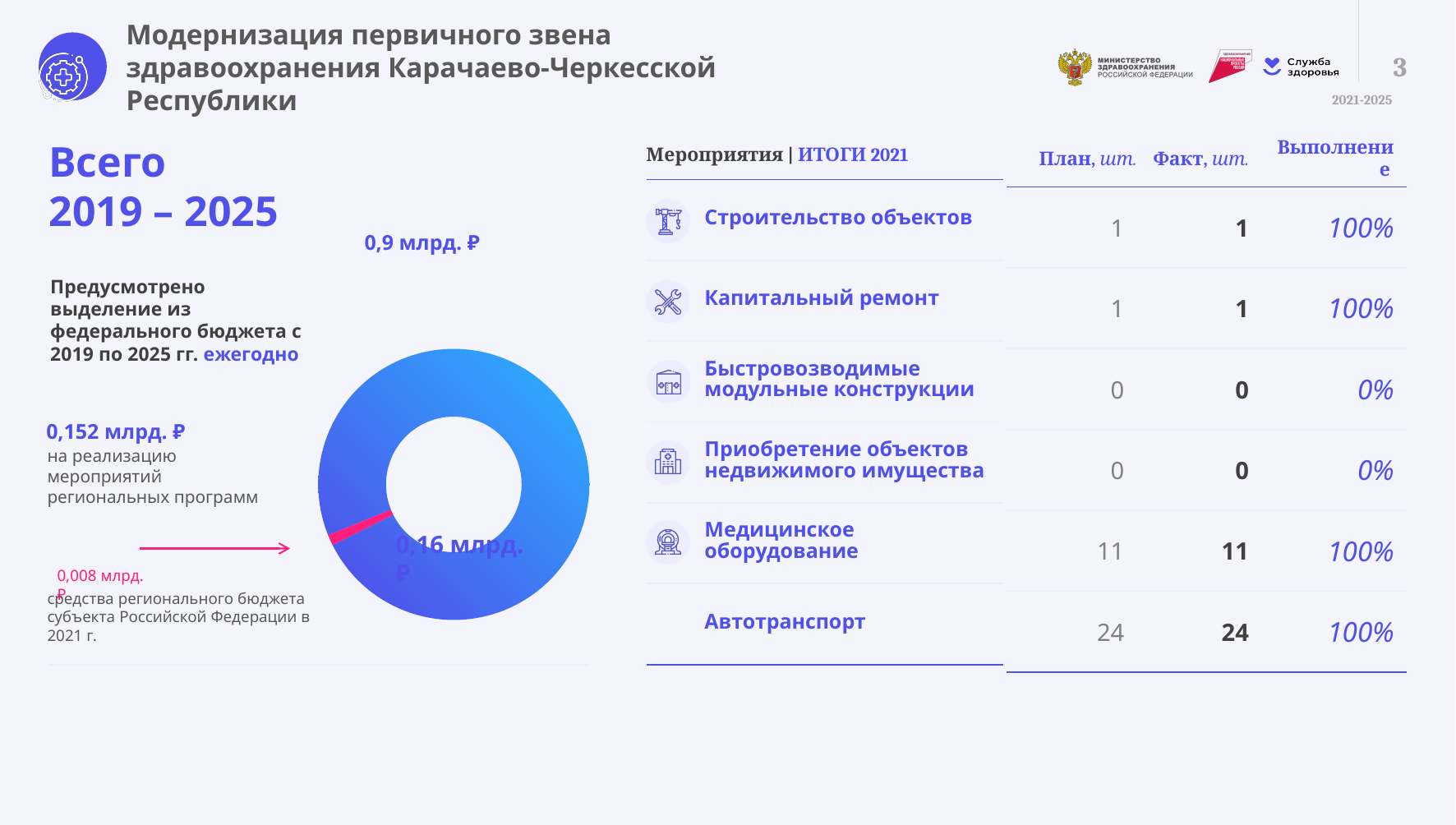
What amount is stated for the implementation of regional programme activities (на реализацию мероприятий региональных программ)? 0,152 млрд. ₽ What value is labelled on the small pink slice of the donut chart? 0,008 млрд. ₽ Which slice of the donut chart is larger, the blue one or the pink one? the blue one What kind of chart is shown on the left side of the slide? pie chart (donut) What value is printed on the large blue slice of the donut chart? 0,16 млрд. ₽ What colour is the small slice of the donut chart? pink What value is printed above the donut chart? 0,9 млрд. ₽ What is the difference between the 0,152 млрд. ₽ for regional programmes and the 0,008 млрд. ₽ from the regional budget? 0,144 млрд. ₽ Which slice of the donut chart is the smallest? the pink slice (0,008 млрд. ₽) What share of the 0,16 млрд. ₽ total does the 0,008 млрд. ₽ pink slice represent? 5% How many slices does the donut chart have? 2